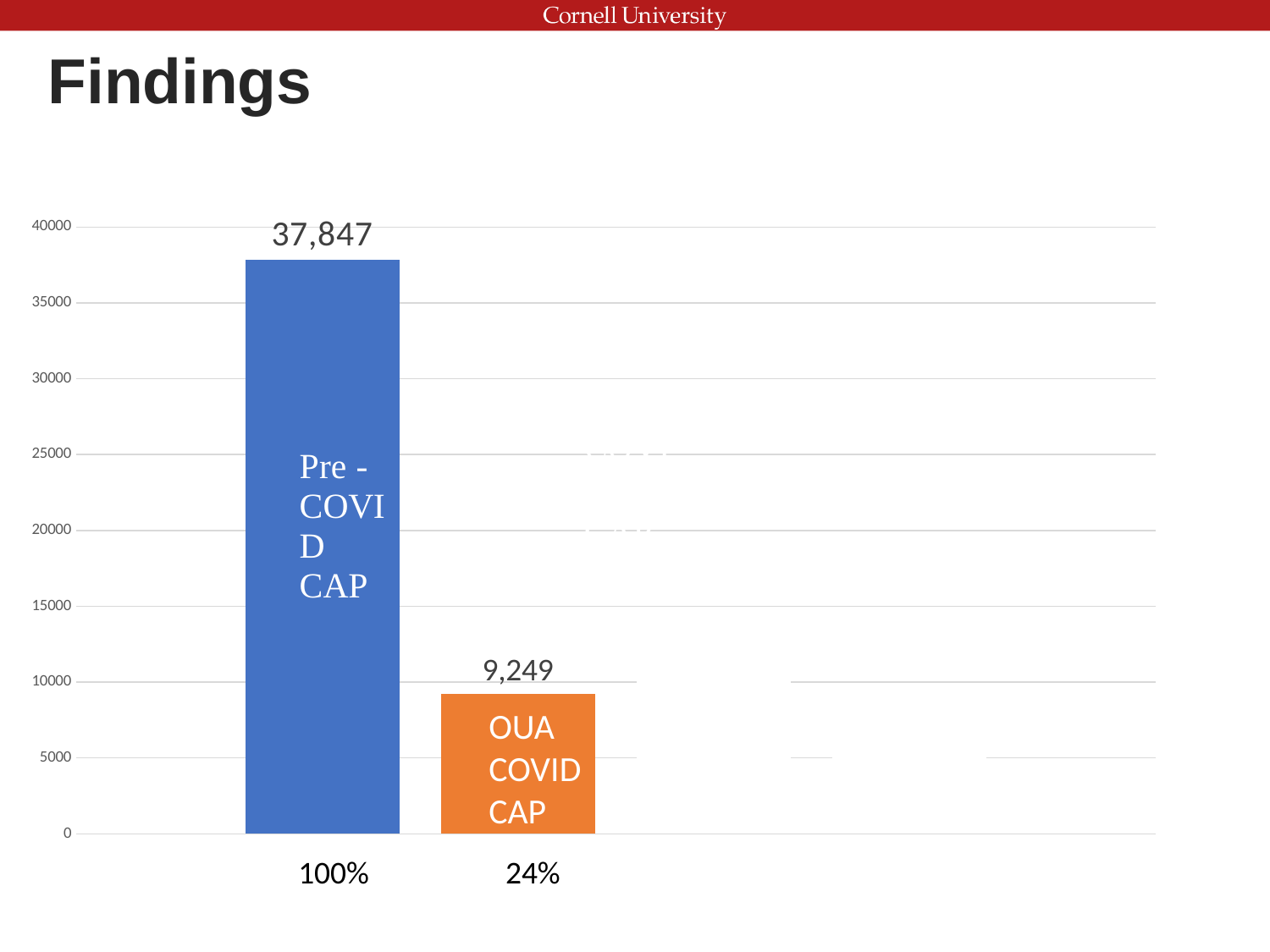
Which bar has the lowest value? OUA COVID CAP What is the value shown for the Pre-COVID CAP bar? 37,847 What colour is the Pre-COVID CAP bar? Blue How many bars are plotted in the chart? 2 What kind of chart is shown on the slide? Bar chart What percentage label is shown beneath the OUA COVID CAP bar? 24% Is the value for Pre-COVID CAP greater or less than 35000? greater Is the value for OUA COVID CAP greater or less than 10000? less Which is larger, the Pre-COVID CAP value or the OUA COVID CAP value? Pre-COVID CAP What is the difference between the Pre-COVID CAP value and the OUA COVID CAP value? 28,598 What is the value shown for the OUA COVID CAP bar? 9,249 Which bar has the highest value? Pre-COVID CAP